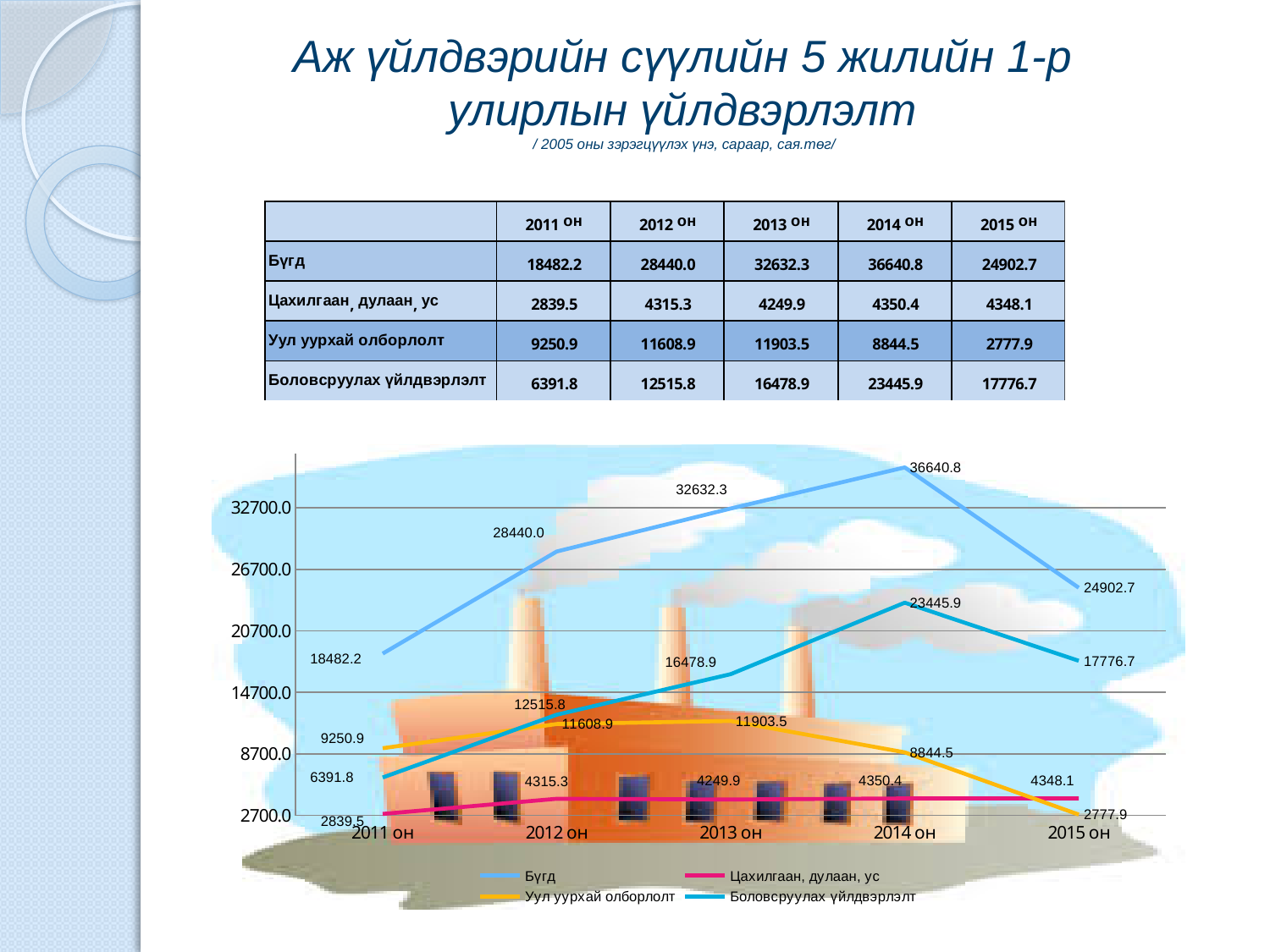
What is the difference between the Бүгд values for 2014 он and 2015 он? 11738.1 Which colour is used for the Бүгд series line in the chart? light blue What is the value of the Бүгд series for 2014 он? 36640.8 How many series does the chart legend list? 4 In which year is the Цахилгаан, дулаан, ус series at its lowest? 2011 он How many years are plotted along the x axis of the chart? 5 Which is larger in 2012 он: Уул уурхай олборлолт or Боловсруулах үйлдвэрлэлт? Боловсруулах үйлдвэрлэлт What is the value of the Уул уурхай олборлолт series for 2015 он? 2777.9 What is the value of the Боловсруулах үйлдвэрлэлт series for 2013 он? 16478.9 Does the Уул уурхай олборлолт series rise or fall from 2013 он to 2015 он? fall In which year does the Бүгд series reach its highest value? 2014 он What kind of chart is shown on the slide? line chart